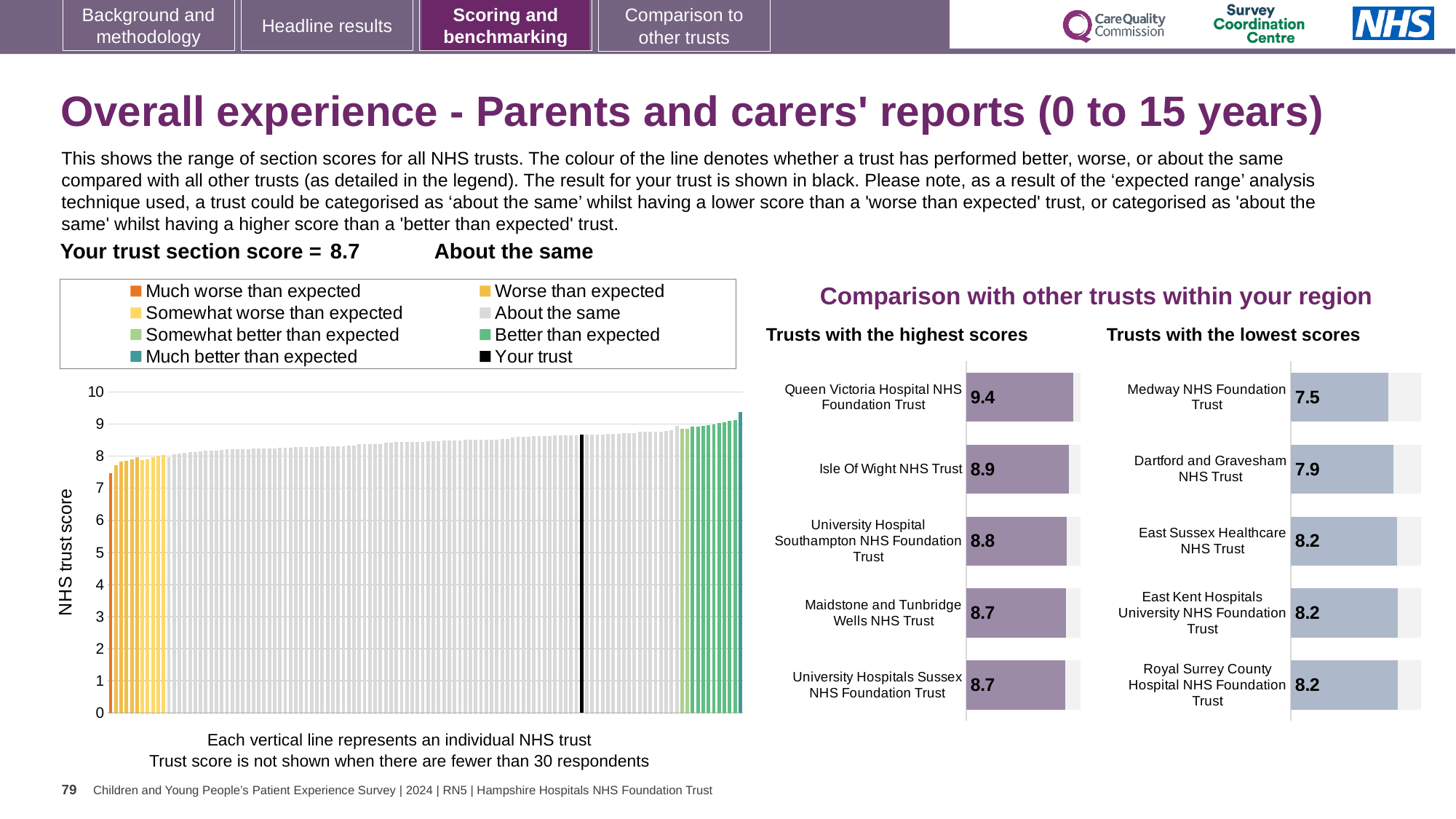
In the 'Trusts with the highest scores' chart, what is the score for Queen Victoria Hospital NHS Foundation Trust? 9.4 In the 'Trusts with the lowest scores' chart, what is the score for Medway NHS Foundation Trust? 7.5 In the 'Trusts with the lowest scores' chart, what is the score for Dartford and Gravesham NHS Trust? 7.9 In the 'Trusts with the lowest scores' chart, what is the difference between the scores of Dartford and Gravesham NHS Trust and Medway NHS Foundation Trust? 0.4 In the 'Trusts with the highest scores' chart, which has the larger score: Queen Victoria Hospital NHS Foundation Trust or University Hospital Southampton NHS Foundation Trust? Queen Victoria Hospital NHS Foundation Trust In the 'Trusts with the lowest scores' chart, which trust has the lowest score? Medway NHS Foundation Trust In the 'Trusts with the highest scores' chart, what is the difference between the scores of Queen Victoria Hospital NHS Foundation Trust and Isle Of Wight NHS Trust? 0.5 How many entries does the legend of the main chart on the left list? 8 In the main chart on the left, is the value for the black 'Your trust' bar greater or less than 8? greater How many trusts are shown in the 'Trusts with the lowest scores' chart? 5 In the 'Trusts with the highest scores' chart, which trust has the highest score? Queen Victoria Hospital NHS Foundation Trust In the 'Trusts with the highest scores' chart, what is the score for University Hospital Southampton NHS Foundation Trust? 8.8